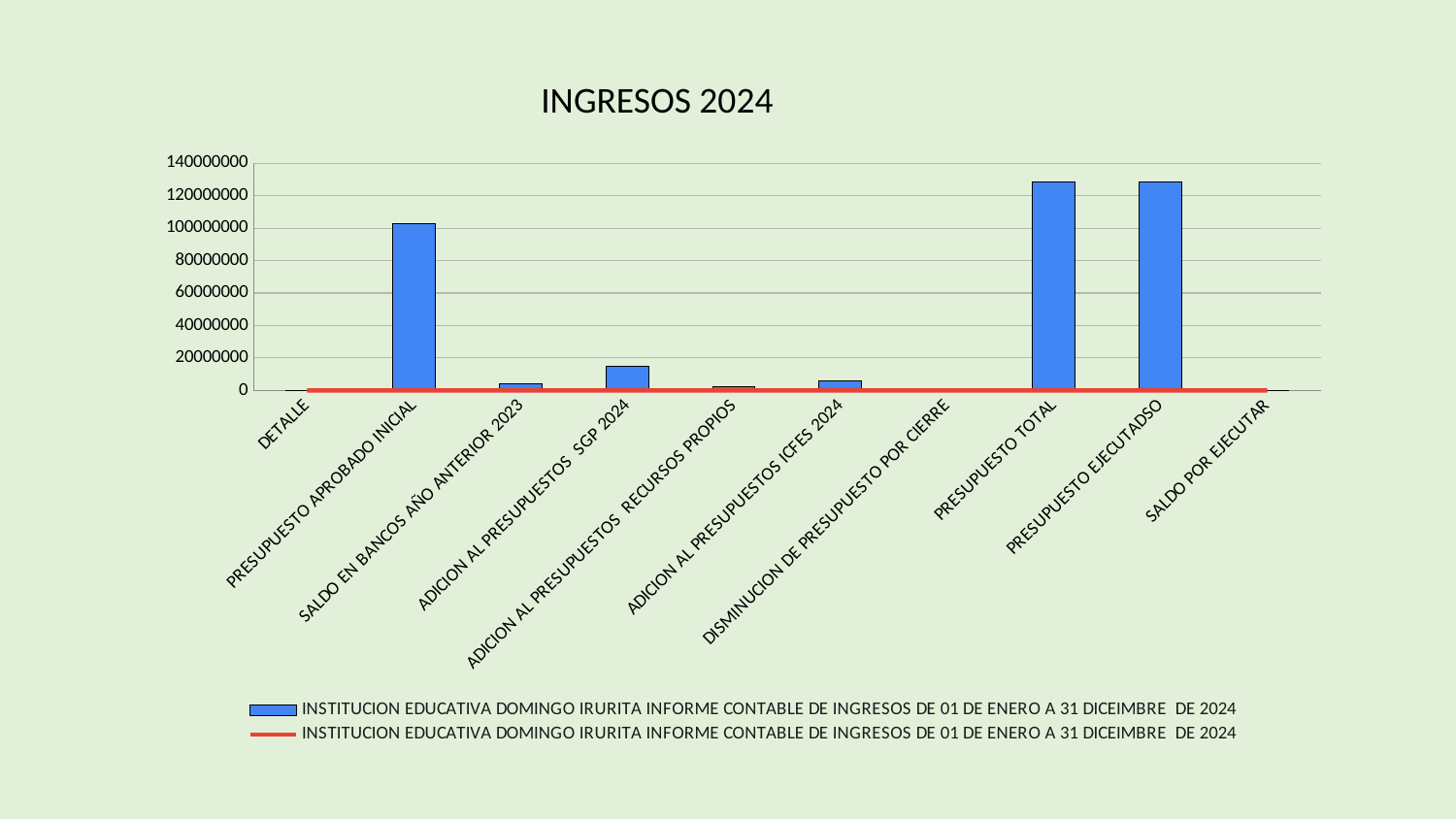
What kind of chart is shown on the slide? Combination bar and line chart How many series does the legend list? 2 What colour are the bars in the chart? Blue Is the value for PRESUPUESTO TOTAL greater or less than 120000000? greater Is the value for PRESUPUESTO APROBADO INICIAL greater or less than 80000000? greater What is the title of the chart? INGRESOS 2024 Is the value for SALDO EN BANCOS AÑO ANTERIOR 2023 greater or less than 20000000? less Which is larger, the value for PRESUPUESTO TOTAL or the value for PRESUPUESTO APROBADO INICIAL? PRESUPUESTO TOTAL Which is larger, the value for ADICION AL PRESUPUESTOS SGP 2024 or the value for SALDO EN BANCOS AÑO ANTERIOR 2023? ADICION AL PRESUPUESTOS SGP 2024 How many categories are shown on the x axis of the chart? 10